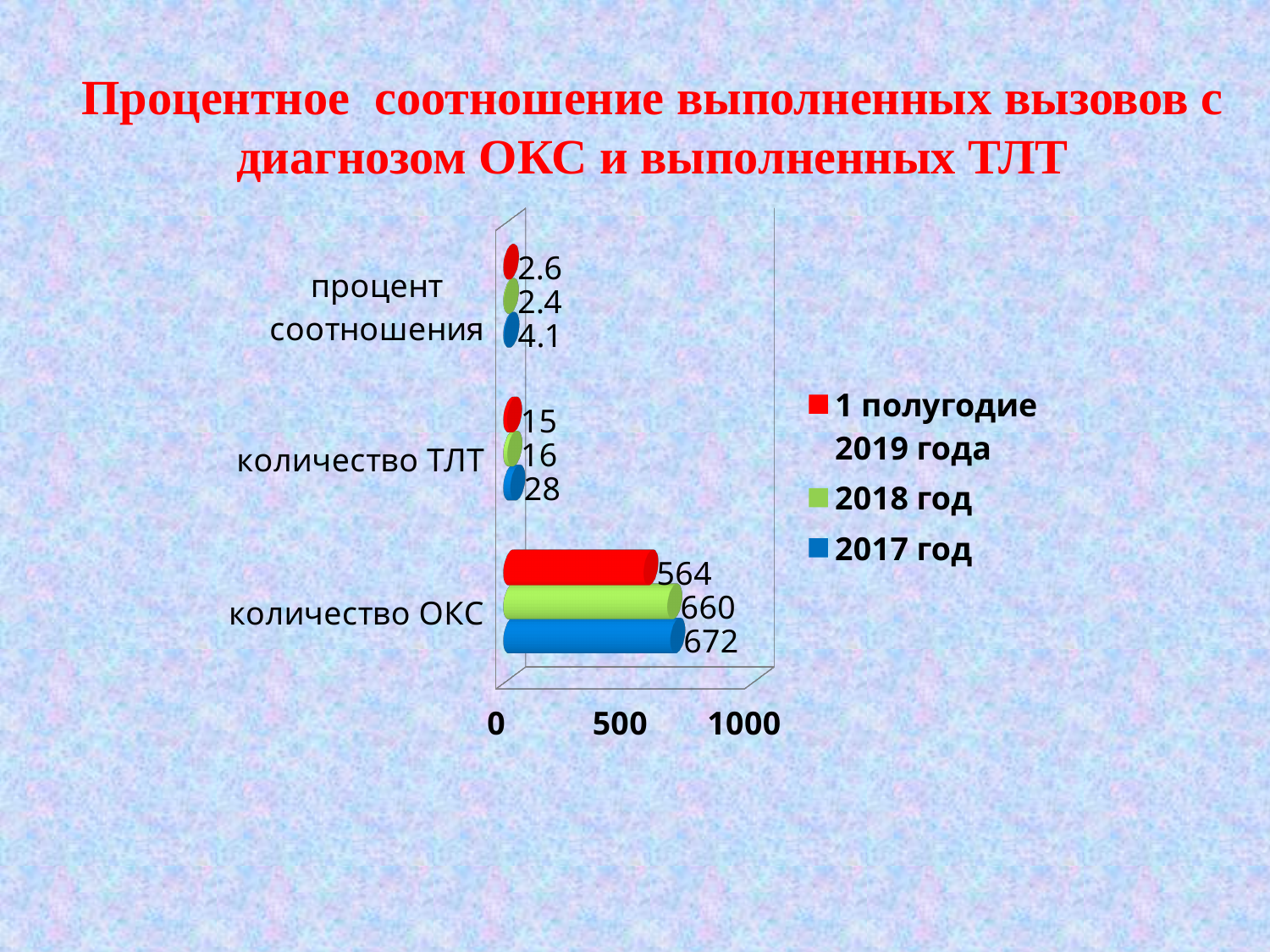
Is the value for количество ОКС in 2018 год greater or less than 500? greater Which year has the highest value for количество ОКС? 2017 год What is the value for процент соотношения in 2018 год? 2.4 Which year has the lowest value for количество ТЛТ? 1 полугодие 2019 года What is the value for количество ОКС in 2017 год? 672 What is the difference between количество ОКС in 2017 год and in 1 полугодие 2019 года? 108 How many categories are shown on the chart? 3 What is the value for количество ОКС in 2018 год? 660 How many series does the legend list? 3 What is the value for количество ТЛТ in 1 полугодие 2019 года? 15 Which is larger: количество ТЛТ in 2017 год or in 2018 год? 2017 год What kind of chart is shown on the slide? bar chart